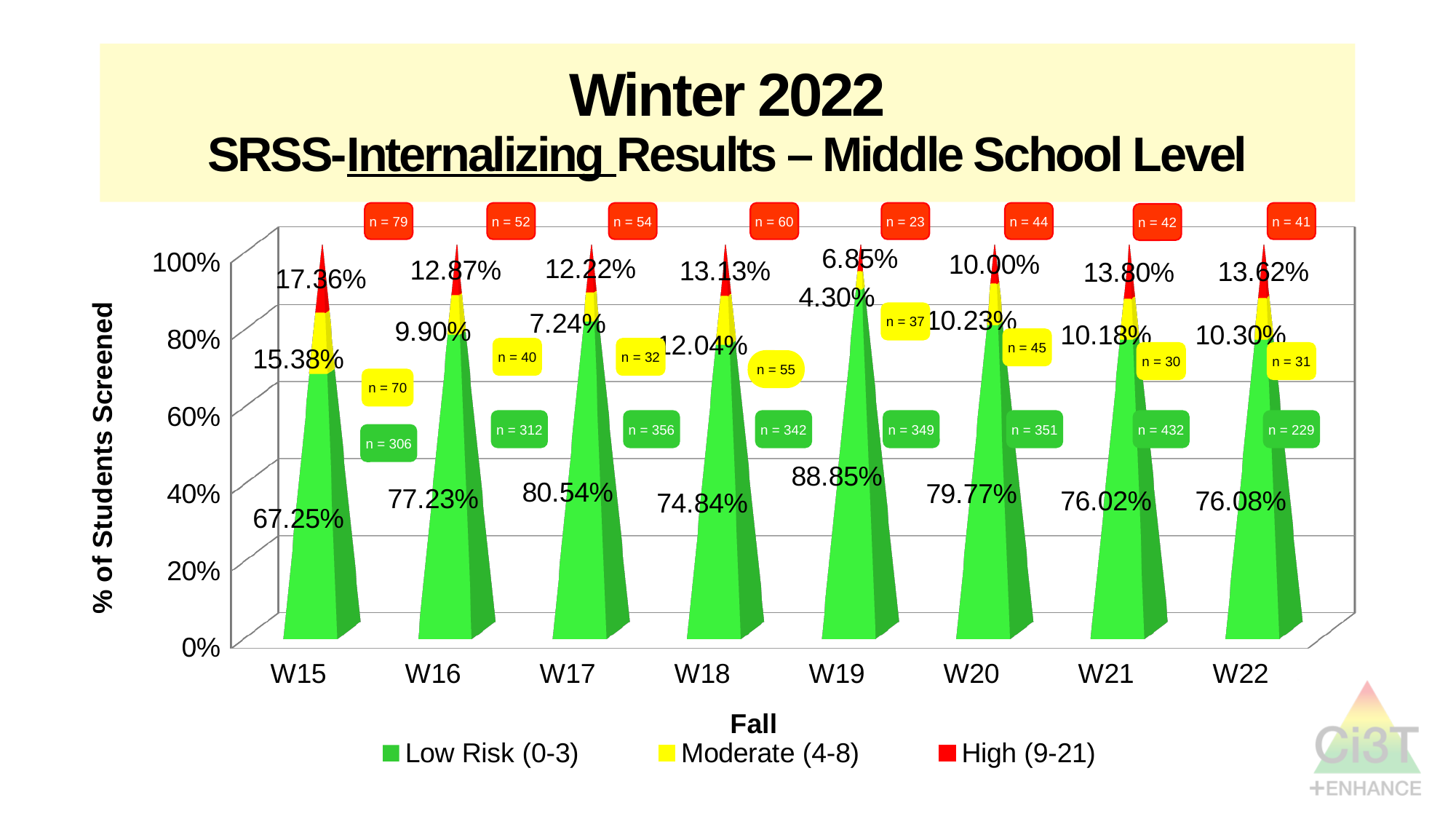
What kind of chart is shown on the slide? Stacked bar chart How many schools are shown on the x axis? 8 Which school has the lowest Low Risk (0-3) percentage? W15 Which school has the highest High (9-21) percentage? W15 How many series does the legend list? 3 Which is larger, the High (9-21) percentage for W16 or for W17? W16 What is the Moderate (4-8) percentage for W18? 12.04% What percentage of students at W15 were in the Low Risk (0-3) category? 67.25% How many students were in the Low Risk (0-3) group at W21 (the n value)? n = 432 What is the High (9-21) percentage for W19? 6.85% Which school has the highest Low Risk (0-3) percentage? W19 What is the difference between the Low Risk (0-3) percentages of W19 and W15? 21.60%